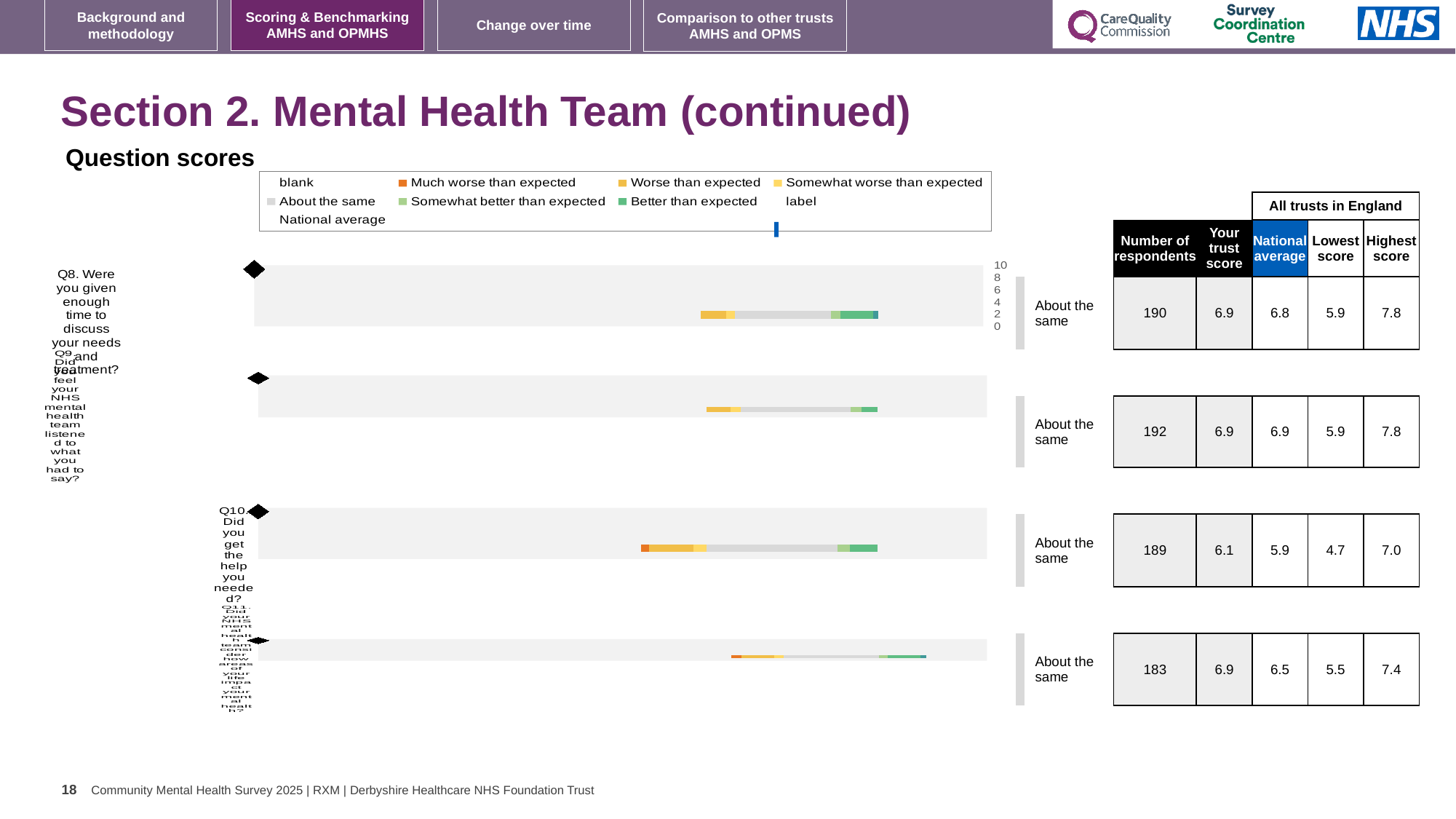
Which question's table row shows the lowest 'Your trust score' on the slide? Q10 In the table beside the Q8 chart, what is the number of respondents? 190 In the legend for the question-score charts, which entry is shown in dark orange? Much worse than expected In the table beside the Q11 chart, what is the national average? 6.5 In the table beside the Q11 chart, what is the difference between your trust score and the national average? 0.4 What label is printed to the right of the Q8 bar chart describing the trust's result? About the same What kind of chart is used for the question scores on this slide? bar chart How many entries does the legend above the question-score charts list? 9 In the table beside the Q10 chart, which is larger: your trust score or the national average? Your trust score In the table beside the Q10 chart, what is your trust score? 6.1 In the table beside the Q9 chart, what is the highest score among all trusts in England? 7.8 How many question-score bar charts are shown on the slide? 4